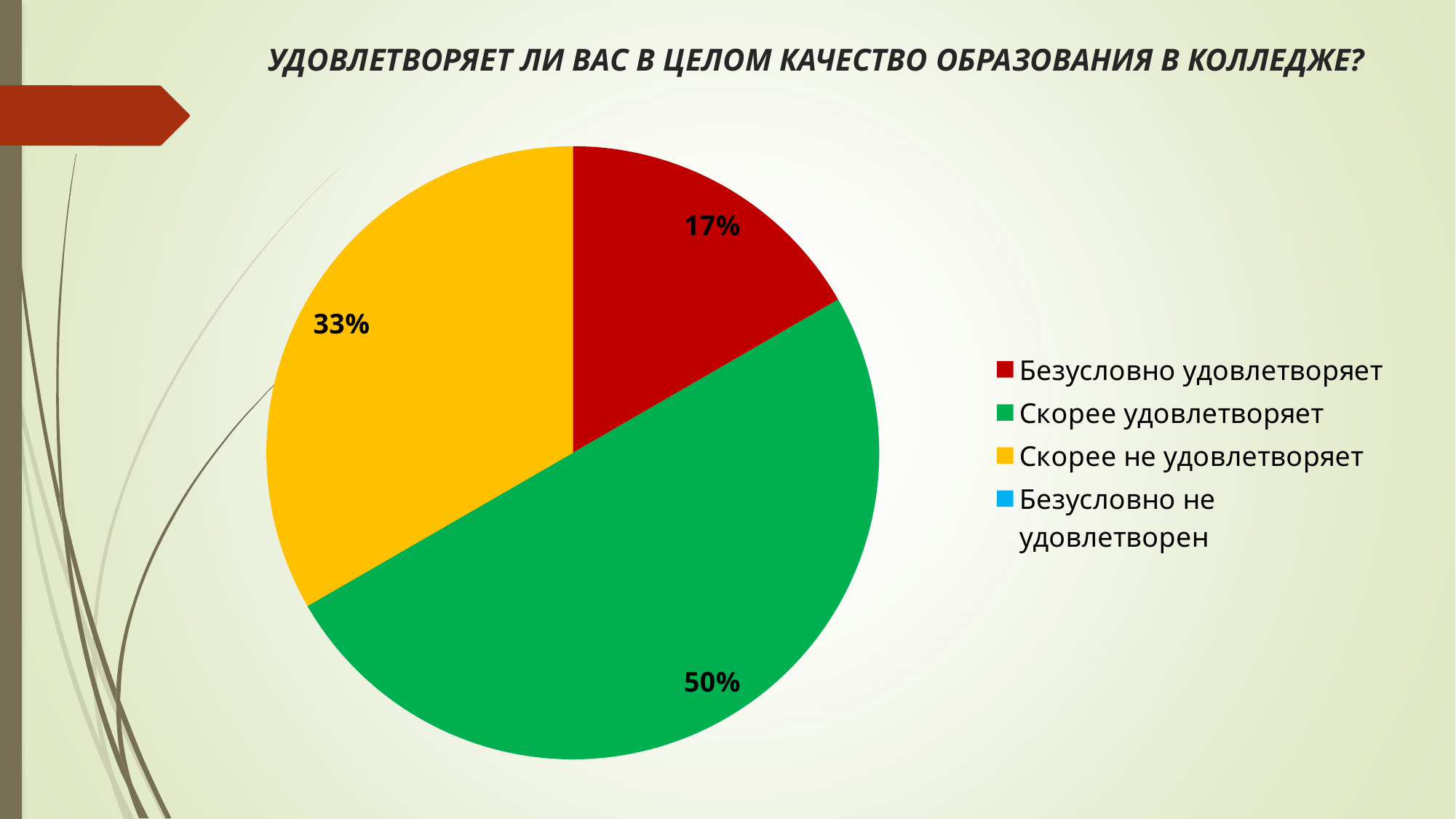
What type of chart is shown on the slide? pie chart What is the title of the chart? УДОВЛЕТВОРЯЕТ ЛИ ВАС В ЦЕЛОМ КАЧЕСТВО ОБРАЗОВАНИЯ В КОЛЛЕДЖЕ? Which labelled slice has the smallest share of the pie? Безусловно удовлетворяет How many categories does the legend list? 4 What is the share for "Скорее не удовлетворяет"? 33% What is the difference between the shares for "Скорее не удовлетворяет" and "Безусловно удовлетворяет"? 16% Which category has the largest share of the pie? Скорее удовлетворяет What is the difference between the shares for "Скорее удовлетворяет" and "Безусловно удовлетворяет"? 33% Which is larger: the share for "Скорее не удовлетворяет" or for "Безусловно удовлетворяет"? Скорее не удовлетворяет What colour is the slice for "Скорее не удовлетворяет"? yellow What is the share for "Безусловно удовлетворяет"? 17% What is the share for "Скорее удовлетворяет"? 50%